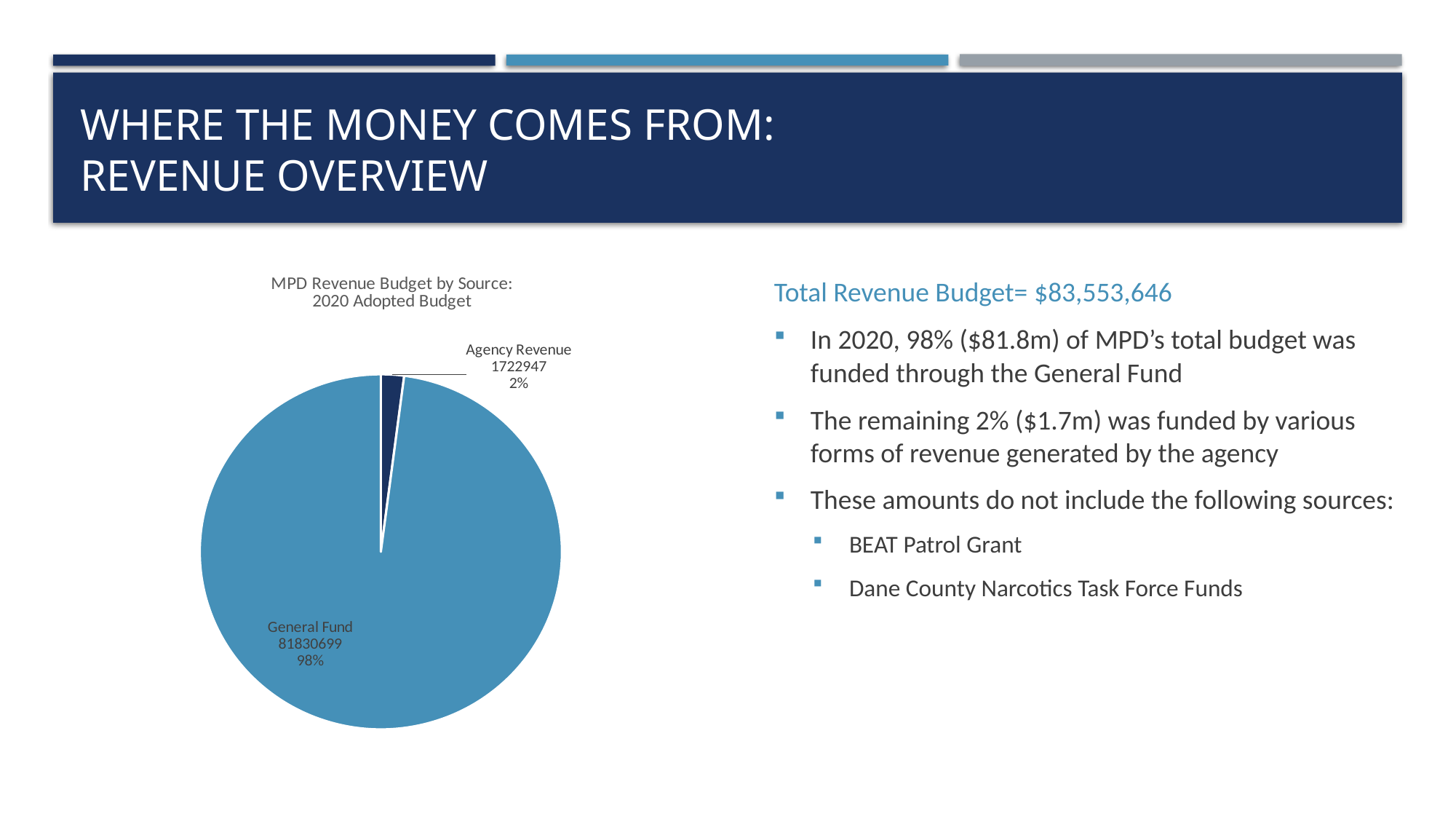
What is the title of the chart? MPD Revenue Budget by Source: 2020 Adopted Budget Which slice is the smallest? Agency Revenue What colour is the Agency Revenue slice? dark navy blue What share of the pie does General Fund represent? 98% What is the difference between the General Fund value and the Agency Revenue value? 80107752 What is the value for General Fund? 81830699 What is the value for Agency Revenue? 1722947 Which slice is the largest? General Fund Which is larger, General Fund or Agency Revenue? General Fund What share of the pie does Agency Revenue represent? 2% How many slices does the pie chart have? 2 What kind of chart is shown on the slide? pie chart